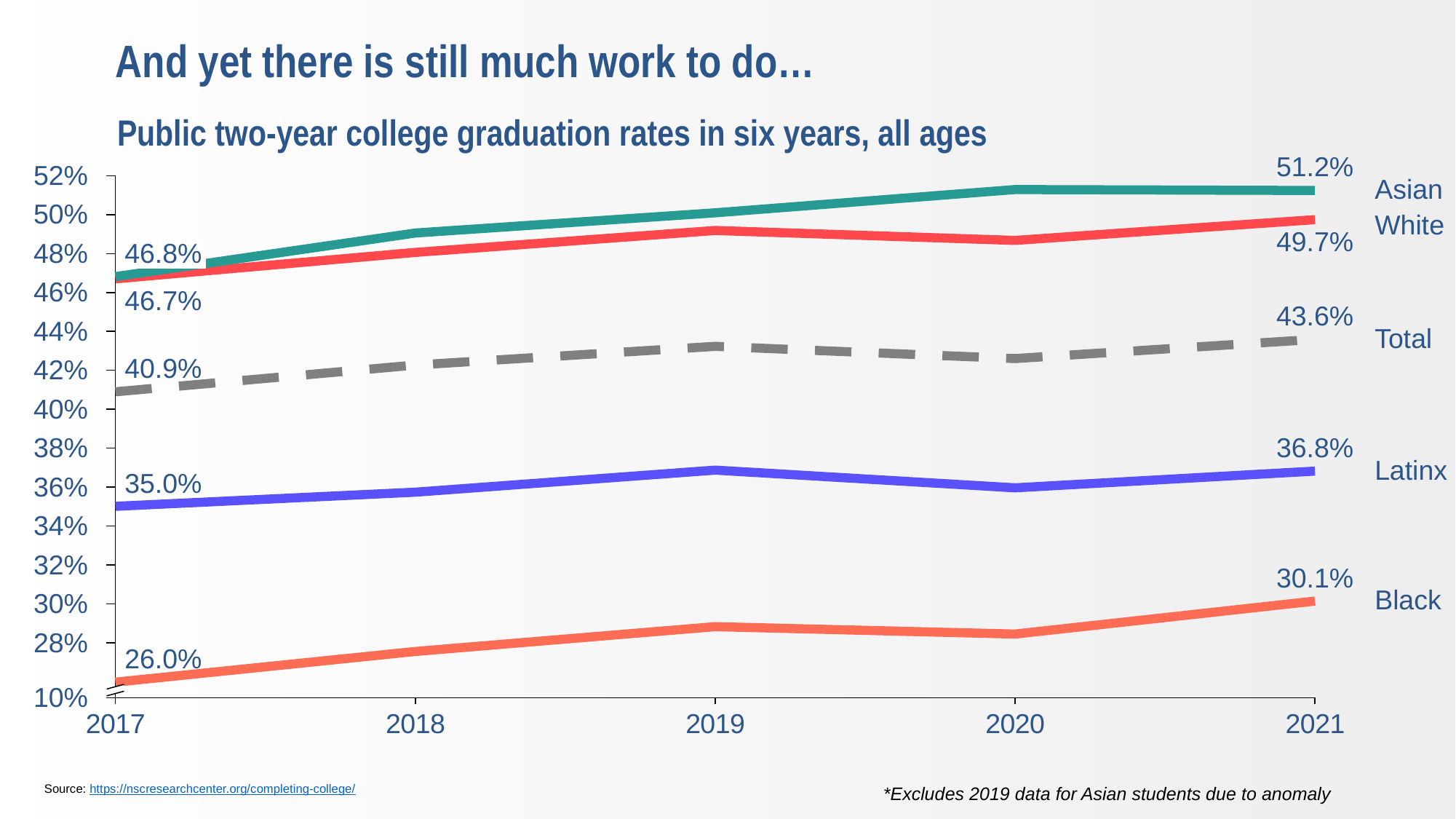
Which group has the highest graduation rate in 2021? Asian Is the White graduation rate in 2019 greater or less than 48%? greater What is the graduation rate for Asian students in 2021? 51.2% By how much did the Black graduation rate change from 2017 to 2021? 4.1% Which group has the lowest graduation rate in 2017? Black What is the Total graduation rate in 2017? 40.9% Is the Latinx graduation rate in 2021 greater or less than the Total rate in 2021? less What is the difference between the Asian and White graduation rates in 2021? 1.5% What type of chart is shown on the slide? line chart What is the graduation rate for Black students in 2021? 30.1% What is the graduation rate for Latinx students in 2017? 35.0% How many groups (lines) are plotted on the chart? 5